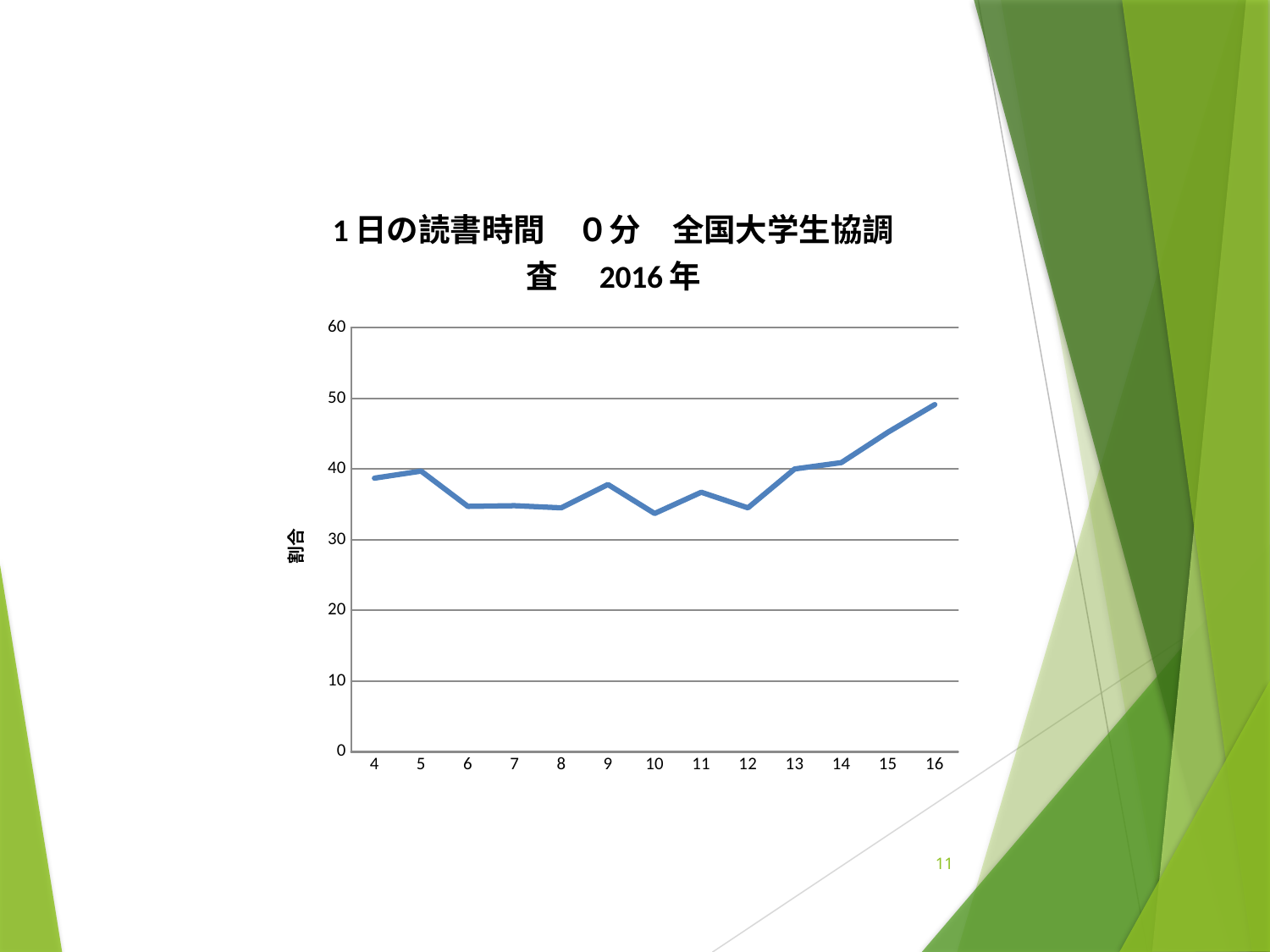
Is the value for 10 greater or less than 30? greater What kind of chart is shown on the slide? line chart What is the label on the y axis? 割合 Is the value for 6 greater or less than 40? less What is the highest value shown on the y axis? 60 Which is larger, the value for 9 or the value for 10? 9 Is the value for 15 greater or less than 40? greater How many points are plotted along the x axis? 13 Do the values rise or fall from 13 to 16 along the x axis? rise Which is larger, the value for 4 or the value for 16? 16 Which x-axis category has the highest value? 16